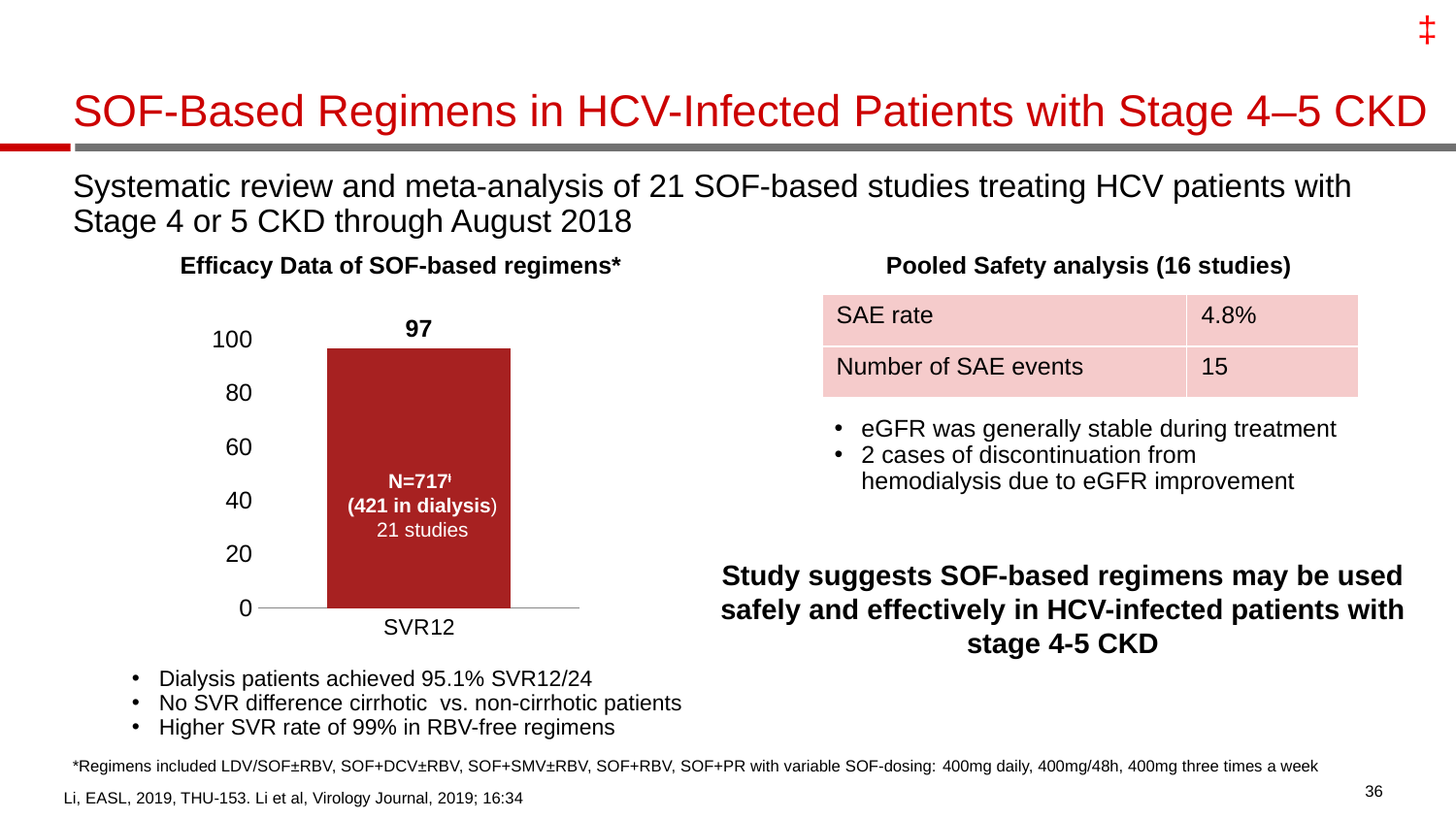
Is the value for SVR12 in the efficacy chart greater or less than 100? less How many categories are plotted on the x axis of the Efficacy Data of SOF-based regimens chart? 1 What is the title of the bar chart on the slide? Efficacy Data of SOF-based regimens* What kind of chart is used to show the Efficacy Data of SOF-based regimens? bar chart According to the text inside the bar of the efficacy chart, how many patients were in dialysis? 421 What is the category label on the x axis of the Efficacy Data of SOF-based regimens chart? SVR12 What is the value shown for SVR12 in the Efficacy Data of SOF-based regimens chart? 97 According to the text inside the bar of the efficacy chart, how many studies contributed to the SVR12 value? 21 studies According to the text inside the bar of the efficacy chart, what is the total N? N=717 What is the maximum value shown on the y axis of the efficacy bar chart? 100 Is the value for SVR12 in the efficacy chart greater or less than 80? greater